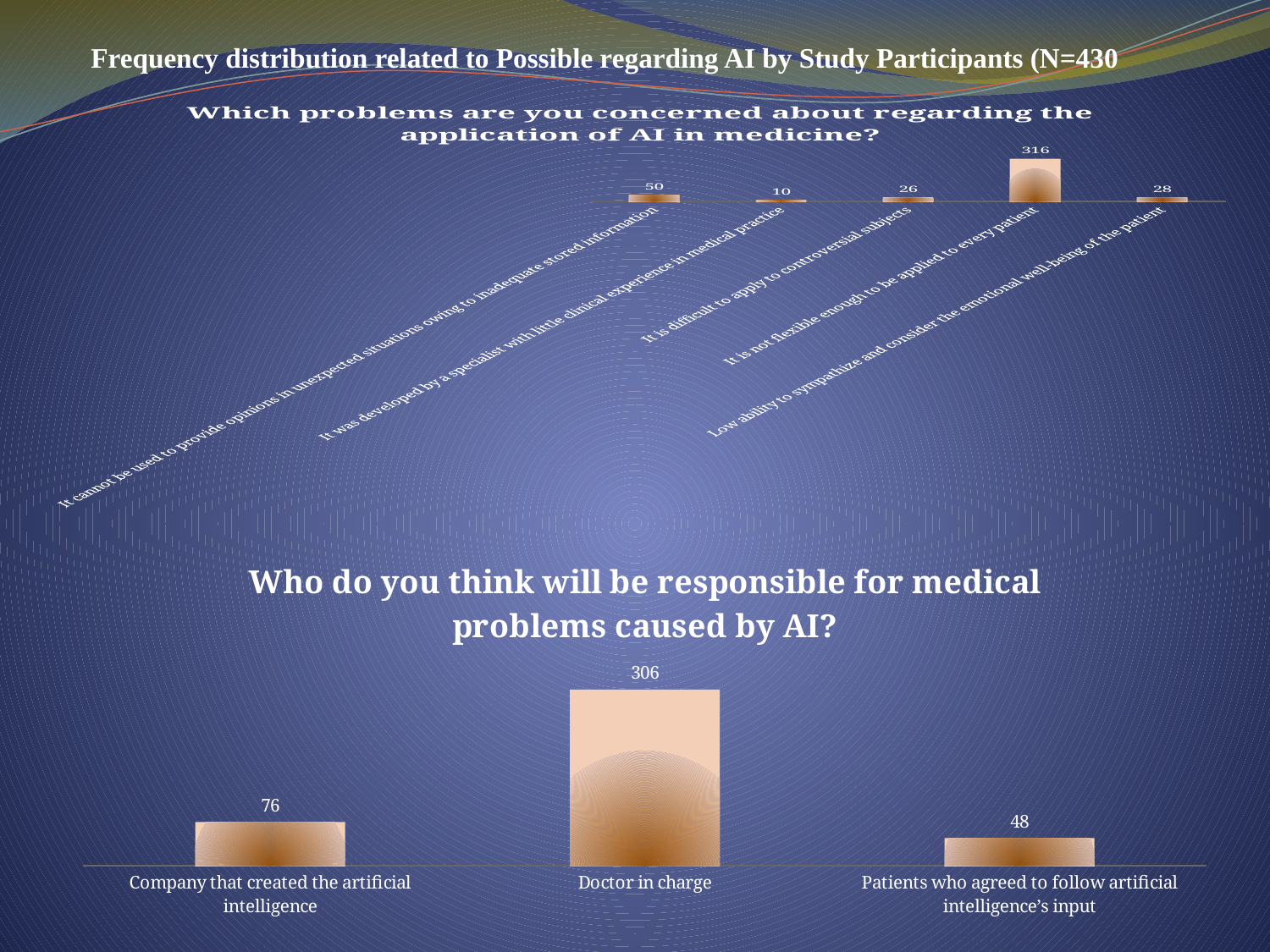
In the chart 'Which problems are you concerned about regarding the application of AI in medicine?', how many categories are shown? 5 In the chart 'Which problems are you concerned about regarding the application of AI in medicine?', which is larger: 'It cannot be used to provide opinions in unexpected situations owing to inadequate stored information' or 'Low ability to sympathize and consider the emotional well-being of the patient'? It cannot be used to provide opinions in unexpected situations owing to inadequate stored information In the chart 'Which problems are you concerned about regarding the application of AI in medicine?', what is the value for 'It is difficult to apply to controversial subjects'? 26 In the chart 'Which problems are you concerned about regarding the application of AI in medicine?', which category has the lowest value? It was developed by a specialist with little clinical experience in medical practice In the chart 'Which problems are you concerned about regarding the application of AI in medicine?', what is the value for 'It is not flexible enough to be applied to every patient'? 316 In the chart 'Who do you think will be responsible for medical problems caused by AI?', which category has the lowest value? Patients who agreed to follow artificial intelligence's input In the chart 'Who do you think will be responsible for medical problems caused by AI?', how many categories are shown? 3 In the chart 'Which problems are you concerned about regarding the application of AI in medicine?', which category has the highest value? It is not flexible enough to be applied to every patient In the chart 'Who do you think will be responsible for medical problems caused by AI?', what is the value for 'Doctor in charge'? 306 In the chart 'Who do you think will be responsible for medical problems caused by AI?', what is the difference between 'Doctor in charge' and 'Company that created the artificial intelligence'? 230 What type of chart is the bottom chart on the slide? Bar chart In the chart 'Who do you think will be responsible for medical problems caused by AI?', what is the value for 'Company that created the artificial intelligence'? 76